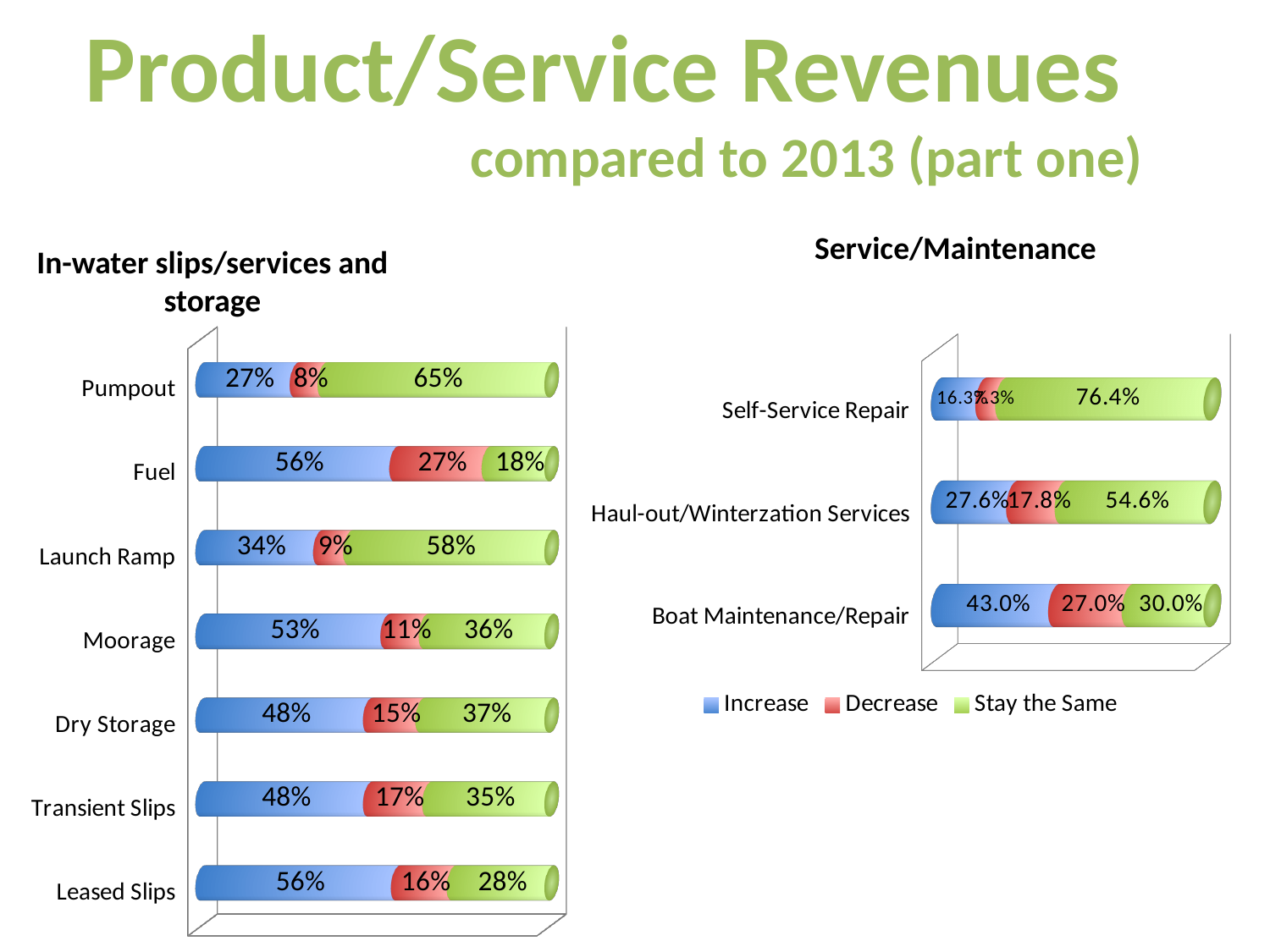
In the 'In-water slips/services and storage' chart, what is the difference between the Increase and Stay the Same values for Moorage? 17 percentage points How many series does the legend of the 'Service/Maintenance' chart list? 3 In the 'In-water slips/services and storage' chart, what is the Decrease value for Fuel? 27% In the 'In-water slips/services and storage' chart, which category has the highest 'Stay the Same' value? Pumpout In the 'In-water slips/services and storage' chart, which category has the lowest Decrease value? Pumpout In the 'Service/Maintenance' chart, what is the Stay the Same value for Haul-out/Winterzation Services? 54.6% In the 'Service/Maintenance' chart, which category has the highest 'Stay the Same' value? Self-Service Repair What type of chart is the 'Service/Maintenance' chart? Stacked bar chart In the 'In-water slips/services and storage' chart, which has the larger Decrease value, Dry Storage or Transient Slips? Transient Slips How many categories are shown in the 'In-water slips/services and storage' chart? 7 In the 'Service/Maintenance' chart, what is the Increase value for Boat Maintenance/Repair? 43.0% In the 'In-water slips/services and storage' chart, what percentage of respondents said Pumpout revenue stayed the same? 65%